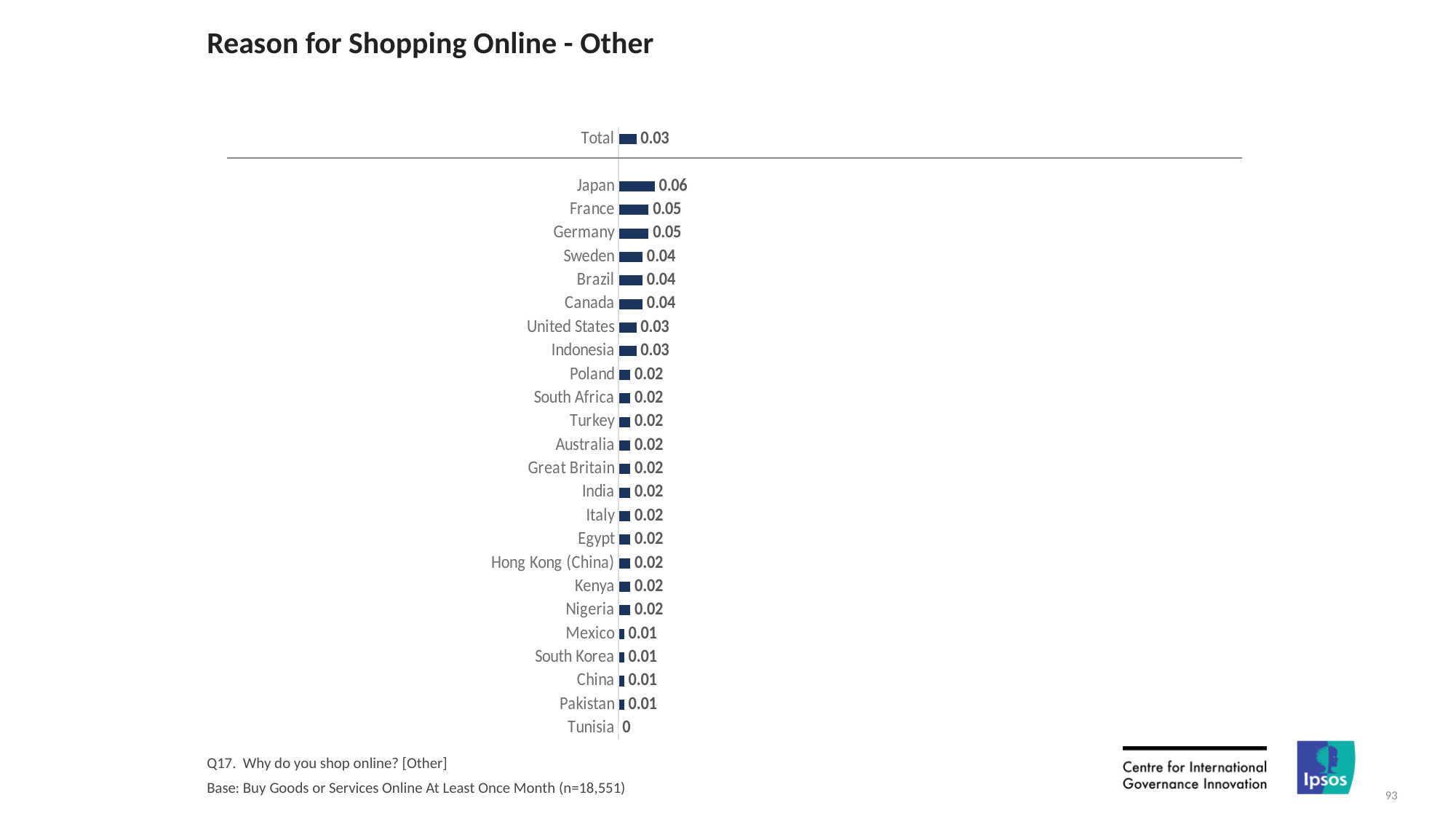
What is the value for Canada? 0.04 What is the value for Total? 0.03 What is the value for Japan? 0.06 What kind of chart is shown on the slide? Bar chart Which has a larger value, France or United States? France Which country has the highest value? Japan What is the difference between the values for Germany and Indonesia? 0.02 What is the difference between the values for Japan and Mexico? 0.05 What is the title of the chart? Reason for Shopping Online - Other What is the value for Tunisia? 0 Which country has the lowest value? Tunisia How many countries are listed on the chart, excluding Total? 24